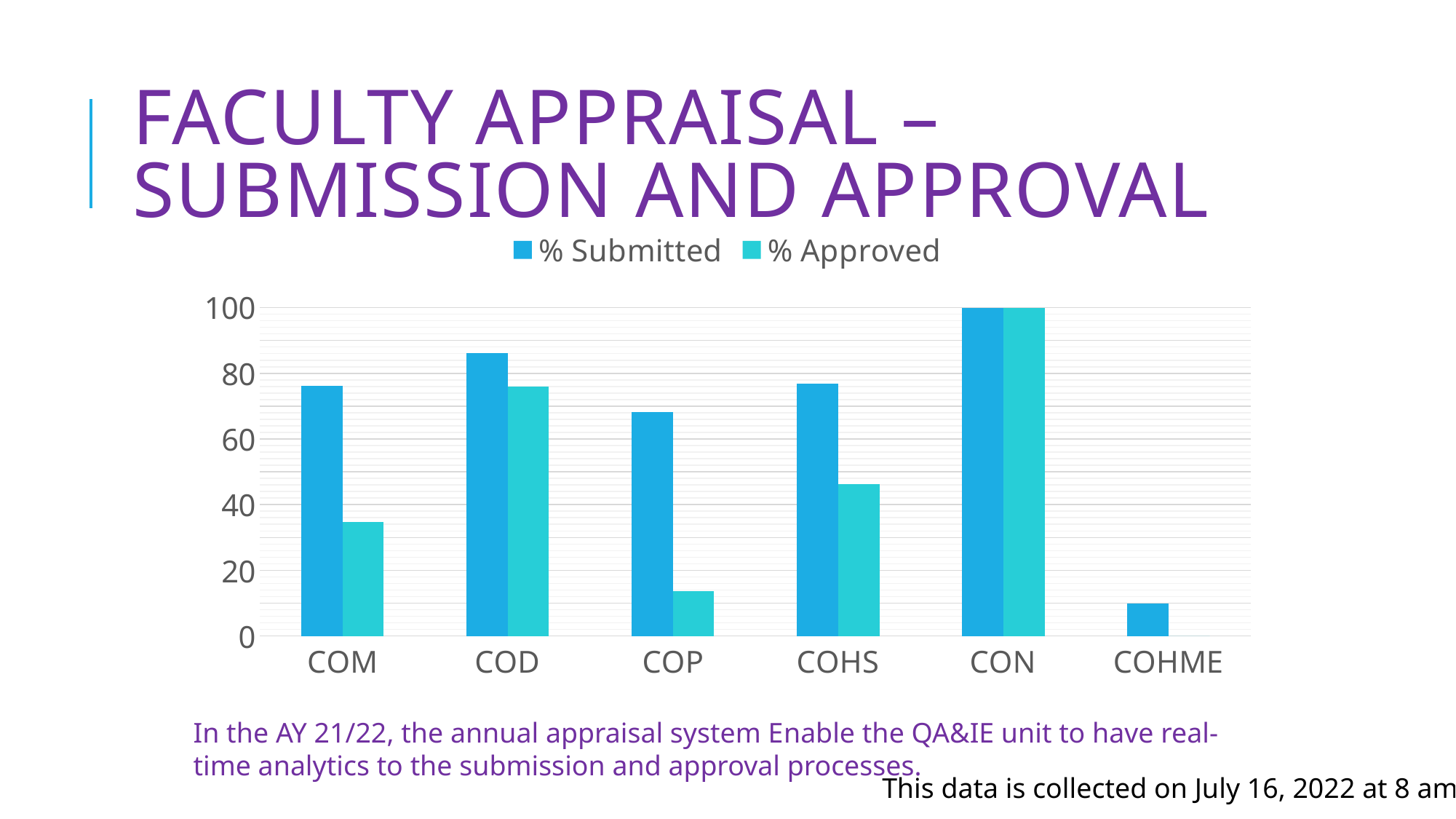
What is the % Submitted value for CON? 100 Is the % Approved value for COM greater or less than 40? less Which category has the lowest % Submitted? COHME What kind of chart is shown on the slide? Bar chart Is the % Submitted value for COHME greater or less than 20? less What is the % Approved value for CON? 100 How many series does the legend list? 2 Which category has the highest % Submitted? CON Which is larger, the % Approved value for COD or the % Approved value for COHS? COD Is the % Submitted value for COD greater or less than 80? greater What are the two series named in the legend? % Submitted and % Approved How many categories are shown on the x axis? 6